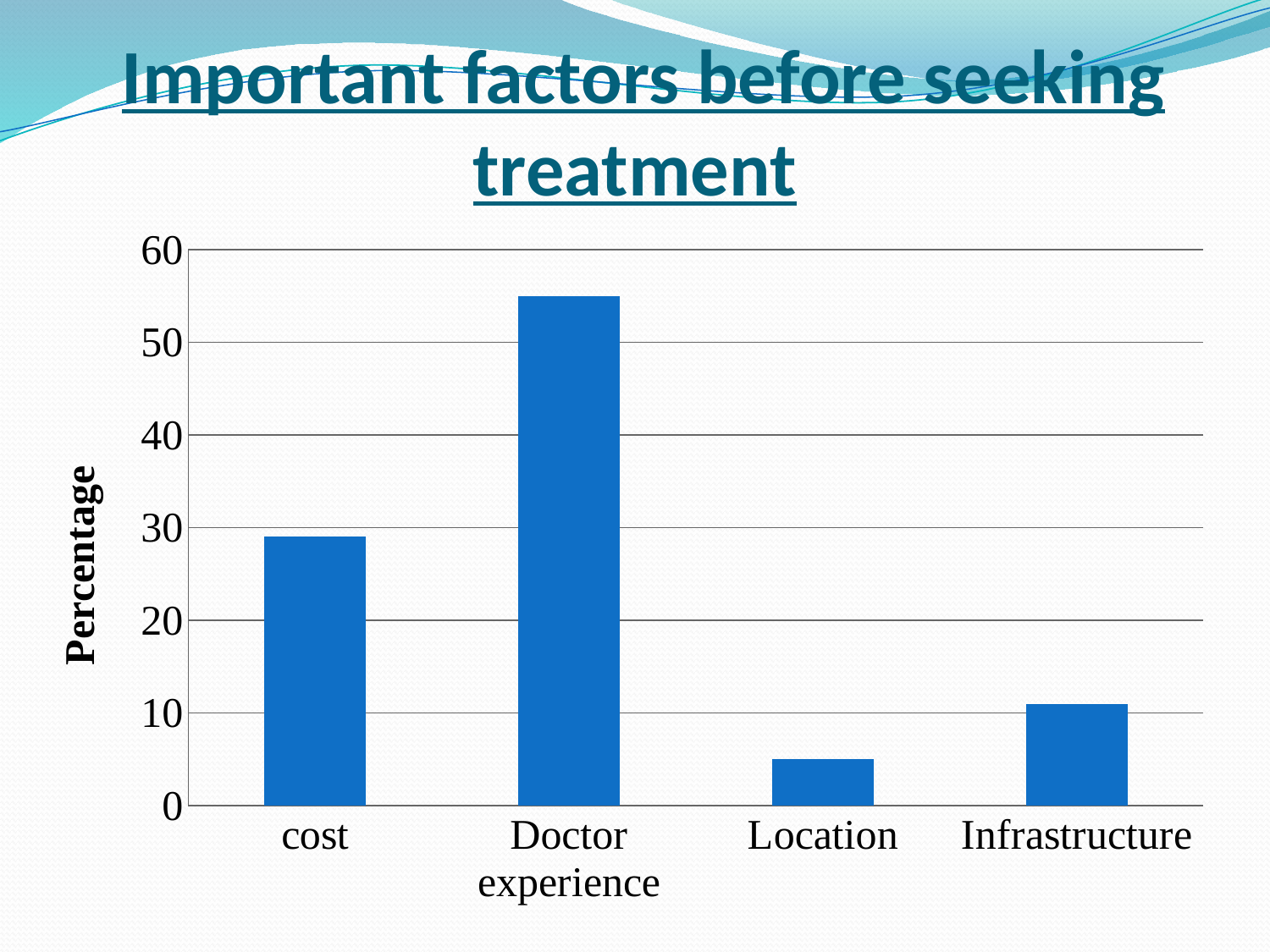
Which has a larger value, Location or Infrastructure? Infrastructure Is the value for Location greater or less than 10? less Which has a larger value, cost or Infrastructure? cost Which factor has the lowest percentage in the chart? Location Is the value for Doctor experience greater or less than 50? greater Is the value for Infrastructure greater or less than 20? less What kind of chart is shown on the slide? bar chart What is the title of the slide containing the chart? Important factors before seeking treatment Which factor has the highest percentage in the chart? Doctor experience What is the label on the vertical axis of the chart? Percentage How many categories are shown on the x axis of the chart? 4